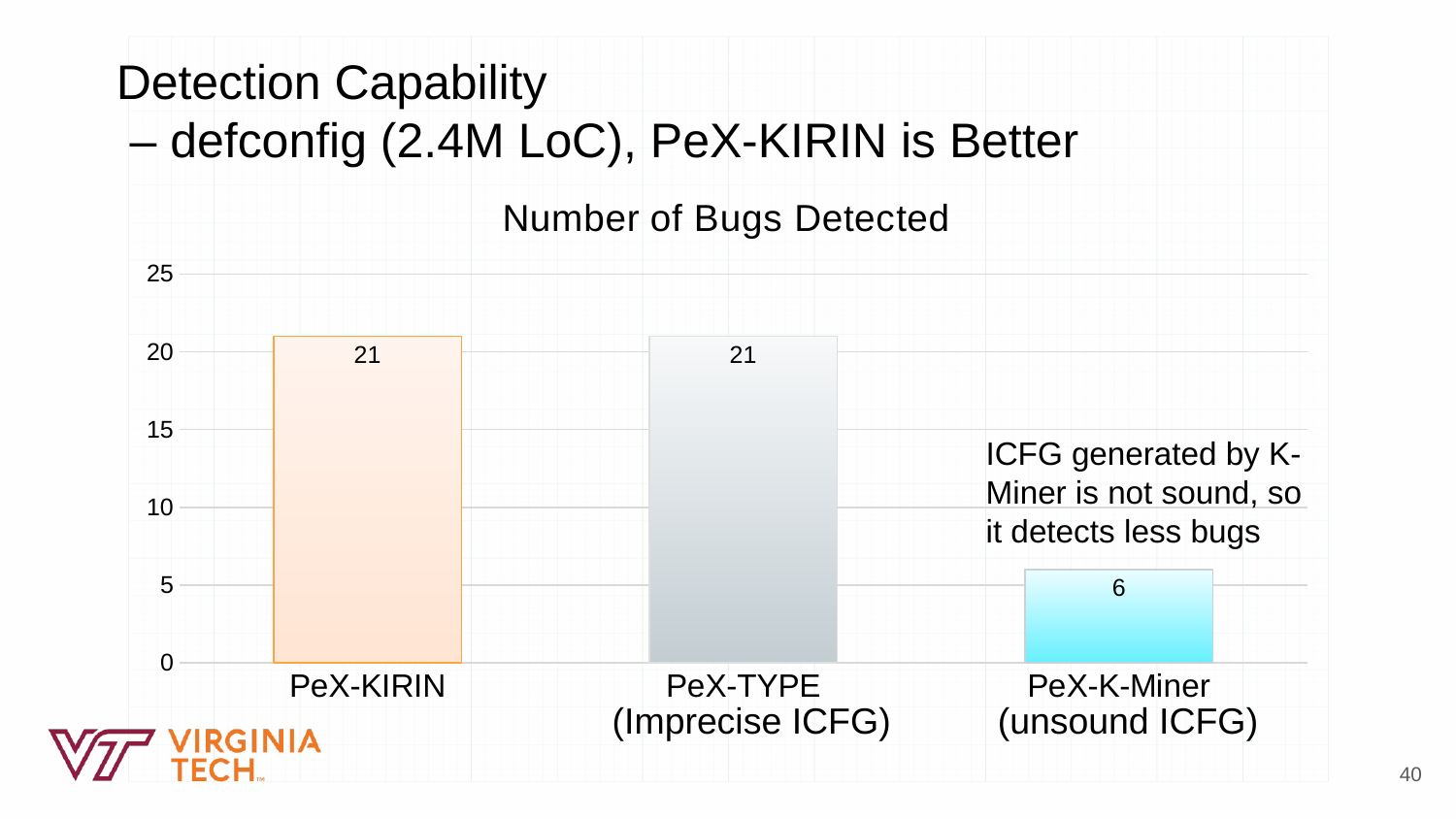
What is the title of the chart? Number of Bugs Detected What kind of chart is shown on the slide? Bar chart What is the maximum value shown on the y axis? 25 Is the value for PeX-KIRIN greater or less than 20? greater What is the difference in bugs detected between PeX-KIRIN and PeX-K-Miner (unsound ICFG)? 15 Which category has the lowest number of bugs detected? PeX-K-Miner (unsound ICFG) Is the value for PeX-K-Miner (unsound ICFG) greater or less than 10? less Which detects more bugs, PeX-TYPE (Imprecise ICFG) or PeX-K-Miner (unsound ICFG)? PeX-TYPE (Imprecise ICFG) What is the number of bugs detected for PeX-TYPE (Imprecise ICFG)? 21 What is the number of bugs detected for PeX-KIRIN? 21 How many categories are shown on the chart? 3 What is the number of bugs detected for PeX-K-Miner (unsound ICFG)? 6